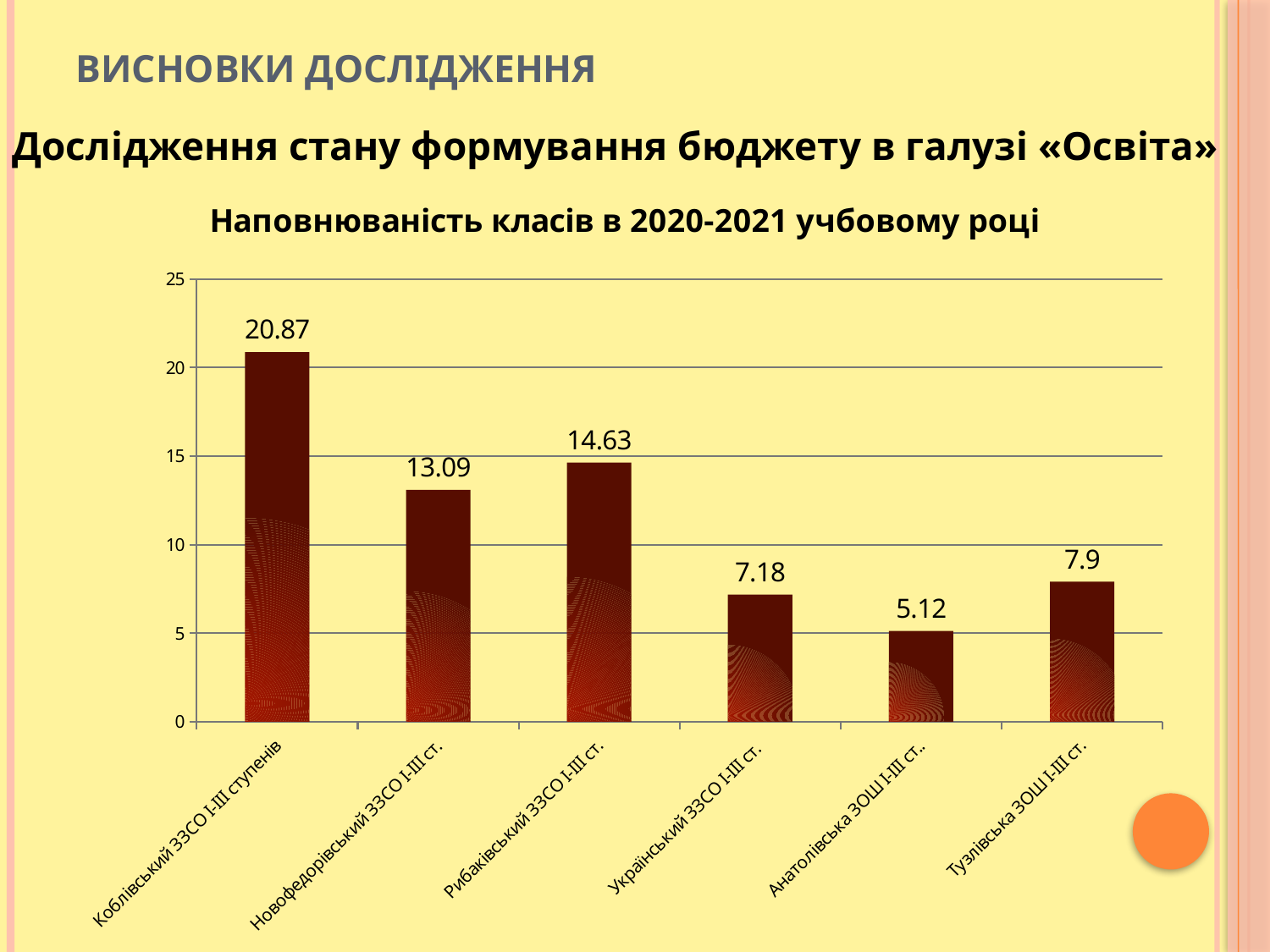
What kind of chart is shown on the slide? bar chart Which is larger, the value for Рибаківський ЗЗСО І-ІІІ ст. or Новофедорівський ЗЗСО І-ІІІ ст.? Рибаківський ЗЗСО І-ІІІ ст. What is the title of the chart? Наповнюваність класів в 2020-2021 учбовому році How many categories are shown in the chart? 6 What is the value for Тузлівська ЗОШ І-ІІІ ст.? 7.9 What is the value for Коблівський ЗЗСО І-ІІІ ступенів? 20.87 Which category has the lowest value? Анатолівська ЗОШ І-ІІІ ст. Which category has the highest value? Коблівський ЗЗСО І-ІІІ ступенів What is the value for Анатолівська ЗОШ І-ІІІ ст.? 5.12 What is the value for Рибаківський ЗЗСО І-ІІІ ст.? 14.63 What is the difference between the values for Коблівський ЗЗСО І-ІІІ ступенів and Новофедорівський ЗЗСО І-ІІІ ст.? 7.78 Is the value for Український ЗЗСО І-ІІІ ст. greater or less than 10? less